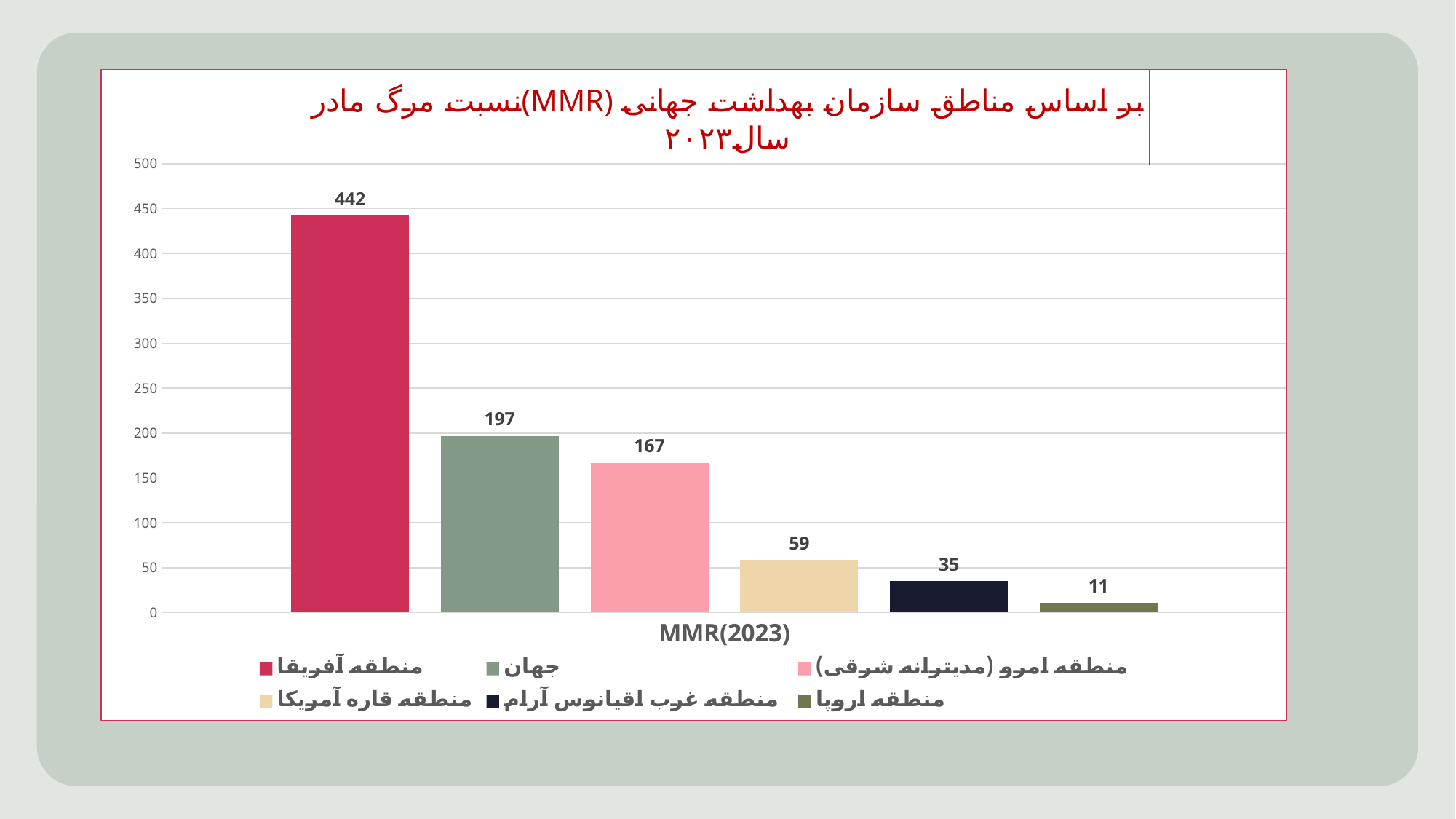
How many entries does the legend list? 6 What type of chart is shown on the slide? Bar chart What label appears on the x axis below the bars? MMR(2023) Which region has the highest MMR value? منطقه آفریقا What is the MMR value for منطقه امرو (مدیترانه شرقی) (Eastern Mediterranean region)? 167 What is the difference between the MMR for منطقه آفریقا (442) and جهان (197)? 245 What is the MMR value for منطقه آفریقا (Africa region)? 442 How many bars are plotted in the chart? 6 Which region has the lowest MMR value? منطقه اروپا What is the MMR value for منطقه اروپا (Europe region)? 11 Which is larger, the MMR for منطقه قاره آمریکا or for منطقه غرب اقیانوس آرام? منطقه قاره آمریکا What is the MMR value for جهان (World)? 197